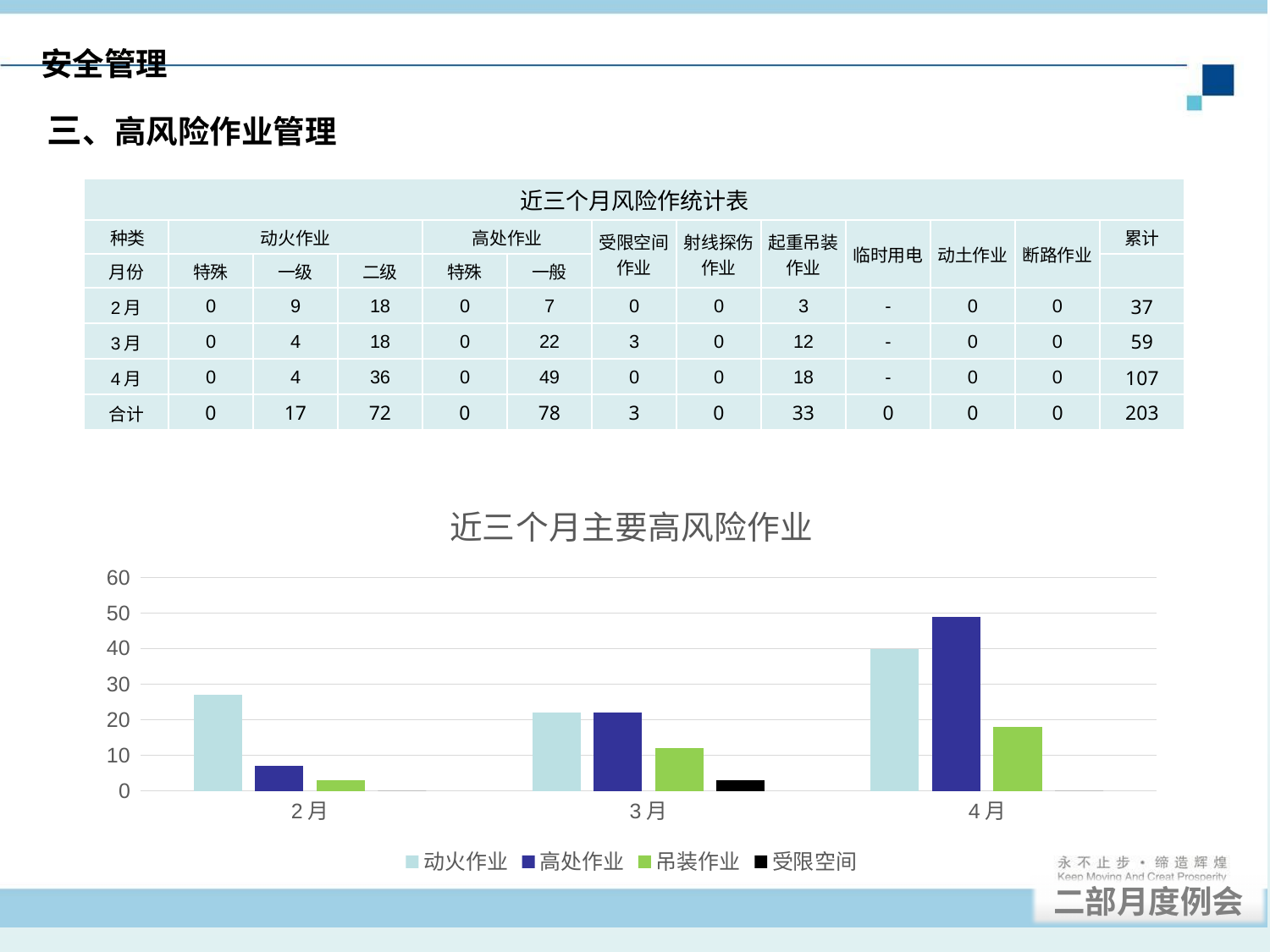
Is the value for 高处作业 in 4月 greater or less than 40? greater Is the value for 动火作业 in 2月 greater or less than 30? less Which month has the highest 动火作业 bar in the chart? 4月 In 4月, which is larger: 高处作业 or 吊装作业? 高处作业 Which month has the lowest 高处作业 bar in the chart? 2月 What kind of chart is shown under the title 近三个月主要高风险作业? bar chart Does the 高处作业 series rise or fall from 2月 to 4月? rise Which series is shown in black in the chart legend? 受限空间 How many month categories are shown on the x axis of the chart? 3 In 2月, which is larger: 动火作业 or 高处作业? 动火作业 Is the value for 吊装作业 in 3月 greater or less than 10? greater How many series does the legend of the chart list? 4